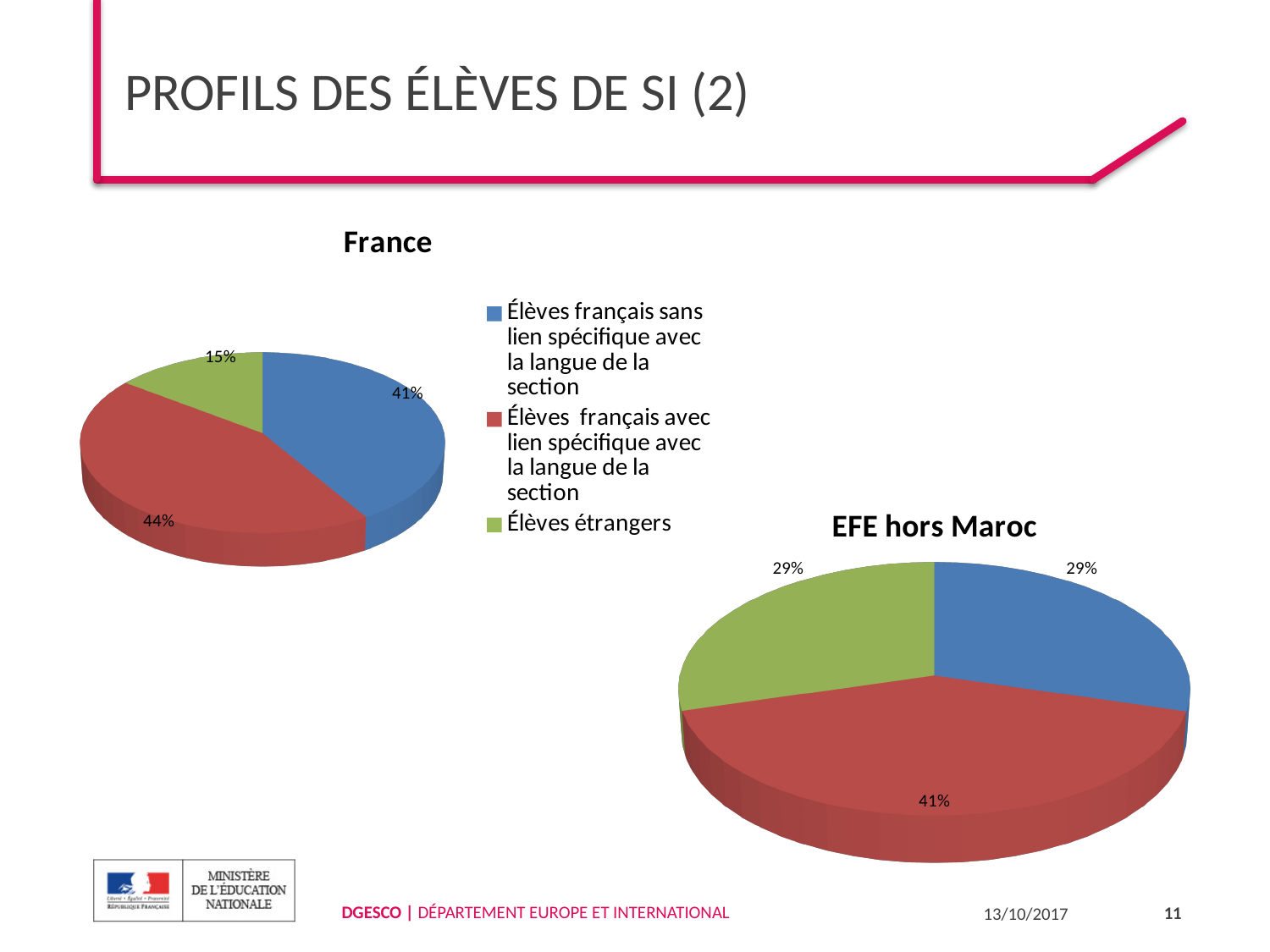
How many slices does the "EFE hors Maroc" pie chart have? 3 In the "EFE hors Maroc" pie chart, what share is shown for the green slice (Élèves étrangers)? 29% In the "France" pie chart, what share is shown for Élèves français sans lien spécifique avec la langue de la section? 41% In the "France" pie chart, what share is shown for Élèves étrangers? 15% In the "France" pie chart, which category has the smallest share? Élèves étrangers Is the share of Élèves étrangers larger in the "France" chart or in the "EFE hors Maroc" chart? EFE hors Maroc In the "France" pie chart, what share is shown for Élèves français avec lien spécifique avec la langue de la section? 44% In the "France" pie chart, what is the difference in percentage points between the share of Élèves français avec lien spécifique and the share of Élèves étrangers? 29 What type of chart is used for "France"? Pie chart In the "EFE hors Maroc" pie chart, which category has the largest share? Élèves français avec lien spécifique avec la langue de la section In the "France" pie chart, which category has the largest share? Élèves français avec lien spécifique avec la langue de la section In the "EFE hors Maroc" pie chart, what share is shown for the red slice (Élèves français avec lien spécifique avec la langue de la section)? 41%